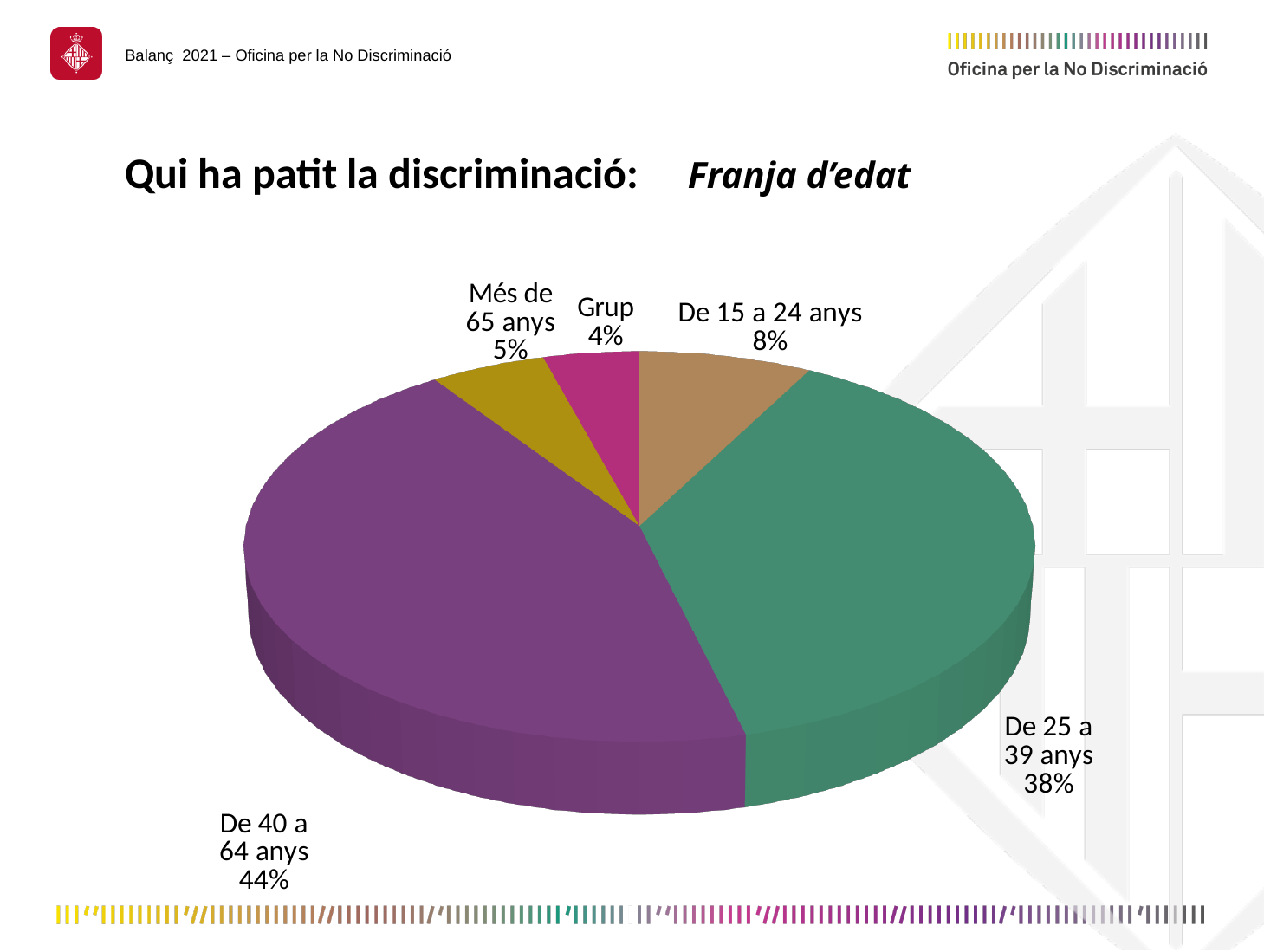
Which category has the smallest share of the pie? Grup What is the value shown for 'De 25 a 39 anys'? 38% How many slices does the pie chart have? 5 Which is larger, the share for 'De 15 a 24 anys' or the share for 'Més de 65 anys'? De 15 a 24 anys What is the value shown for 'Més de 65 anys'? 5% What kind of chart is shown on the slide? pie chart Which age group has the largest share of the pie? De 40 a 64 anys What share of the pie does 'De 40 a 64 anys' represent? 44% What colour is the slice for 'De 25 a 39 anys'? green What is the difference in percentage points between 'De 40 a 64 anys' and 'De 25 a 39 anys'? 6 What is the value shown for 'Grup'? 4% What is the value shown for 'De 15 a 24 anys'? 8%